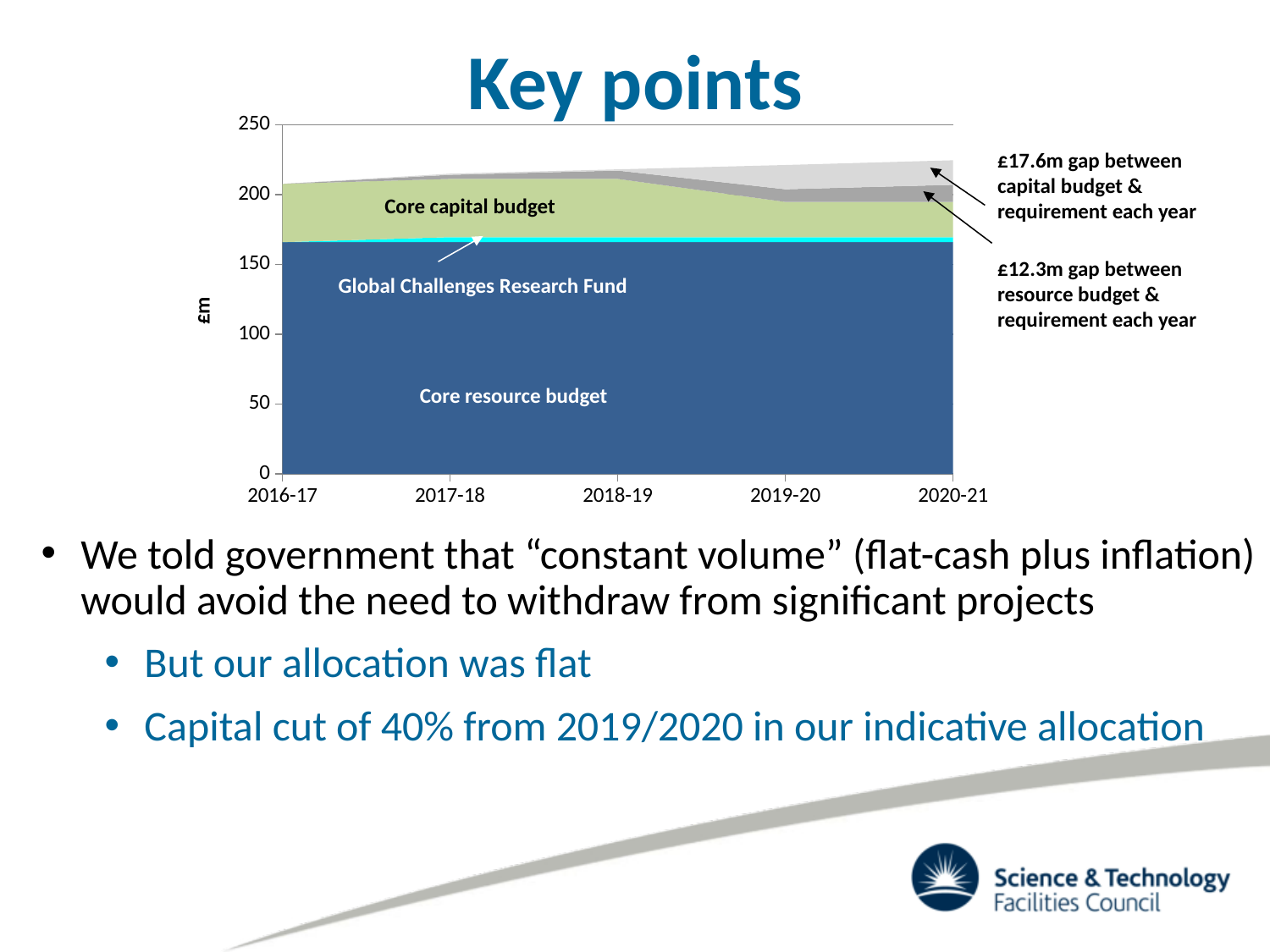
Does the core resource budget rise, fall or stay flat across the years shown? stay flat What kind of chart is shown on the slide? Stacked area chart Is the core resource budget in 2020-21 greater or less than 200? less How many financial years are shown on the x axis of the chart? 5 Does the core capital budget rise or fall between 2018-19 and 2019-20? fall Is the top of the core capital budget area in 2016-17 greater or less than 200? greater How many named budget areas are labelled inside the chart? 3 What is the label on the y axis of the chart? £m Is the core resource budget in 2016-17 greater or less than 150? greater According to the annotation, what is the gap between the capital budget and requirement each year? £17.6m According to the annotation, what is the gap between the resource budget and requirement each year? £12.3m Which budget area is plotted at the bottom of the stacked chart? Core resource budget